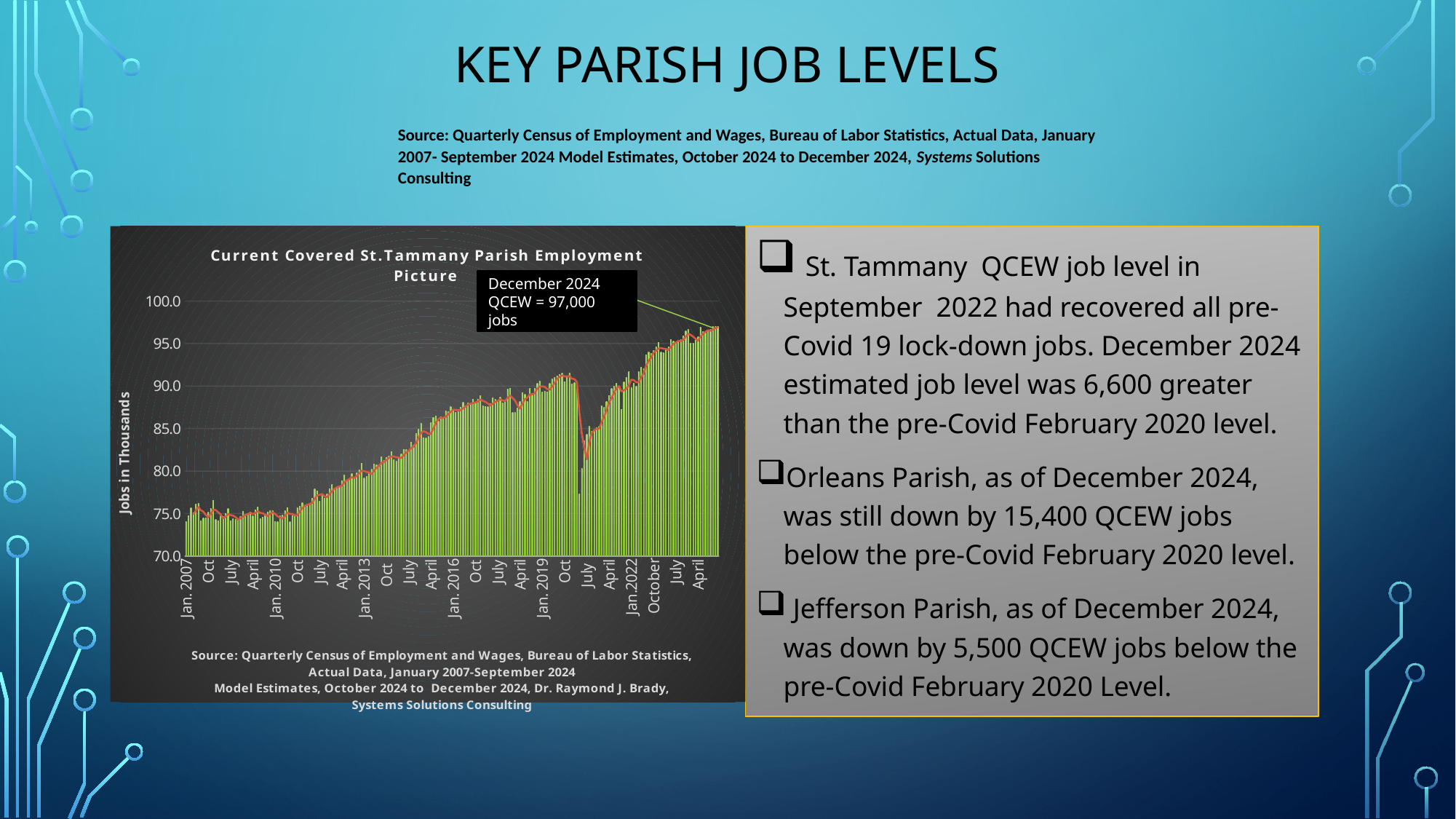
What is the label on the vertical axis of the chart? Jobs in Thousands Overall, do the job levels rise or fall from Jan. 2007 to the end of the chart? rise What kind of chart is used to show St. Tammany Parish employment? bar chart Is the value for Jan. 2007 greater or less than 80.0? less Which is larger, the value for Jan. 2007 or the value for Jan. 2016? Jan. 2016 What is the highest tick value shown on the vertical axis? 100.0 Which is larger, the value for Oct 2019 or the value for July 2020? Oct 2019 What is the title of the chart on the slide? Current Covered St.Tammany Parish Employment Picture Is the value for Jan. 2013 greater or less than 85.0? less According to the annotation on the chart, what is the December 2024 QCEW job level? 97,000 jobs Is the value for Jan. 2016 greater or less than 85.0? greater